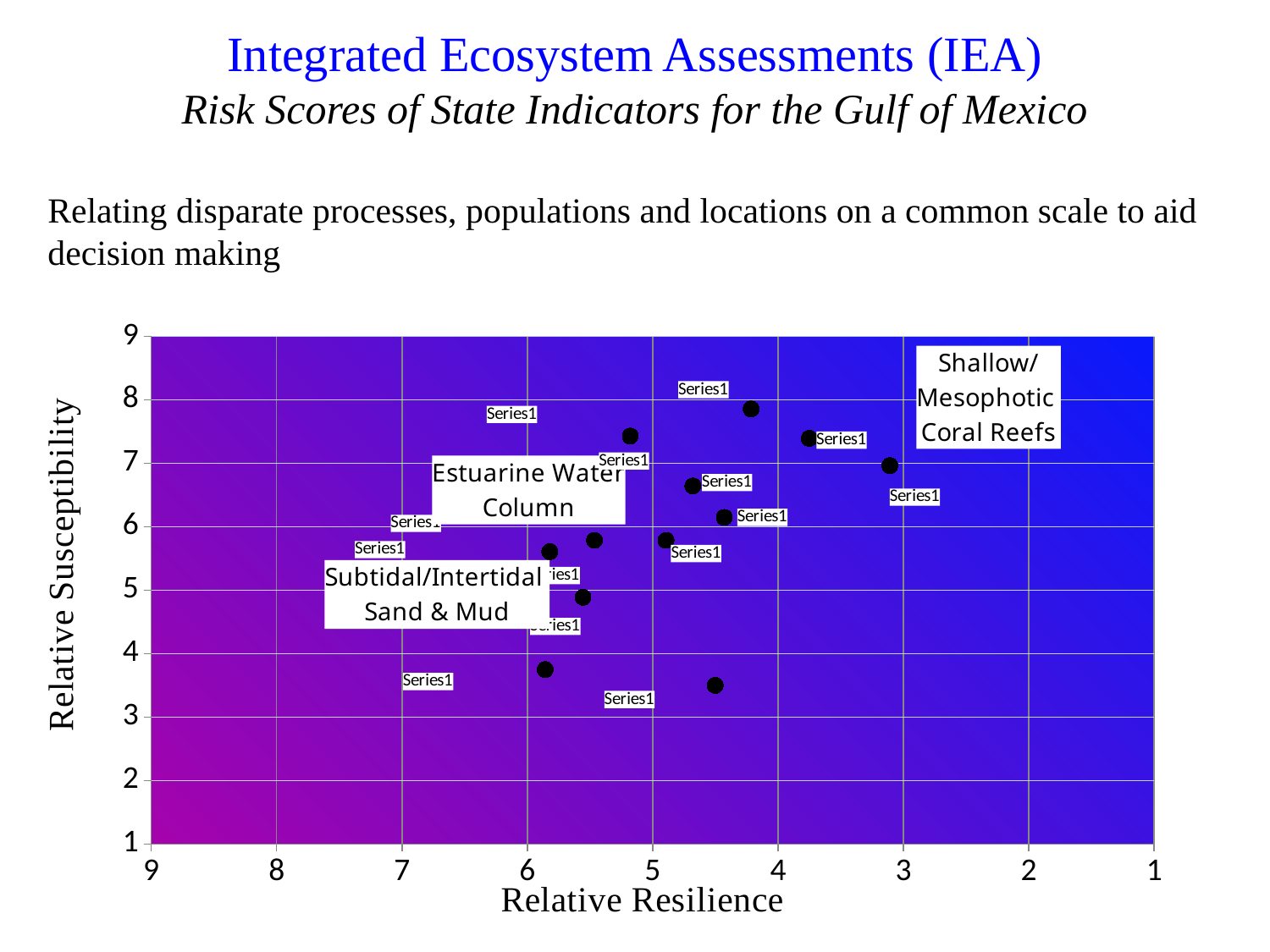
Are any plotted points at a Relative Susceptibility less than 3? No What is the title of the vertical axis of the chart? Relative Susceptibility Is the Relative Resilience of the point with the highest Relative Susceptibility greater or less than 5? less Is the Relative Susceptibility of the rightmost plotted point (lowest Relative Resilience) greater or less than 6? greater What kind of chart is shown on the slide? scatter chart What is the title of the horizontal axis of the chart? Relative Resilience